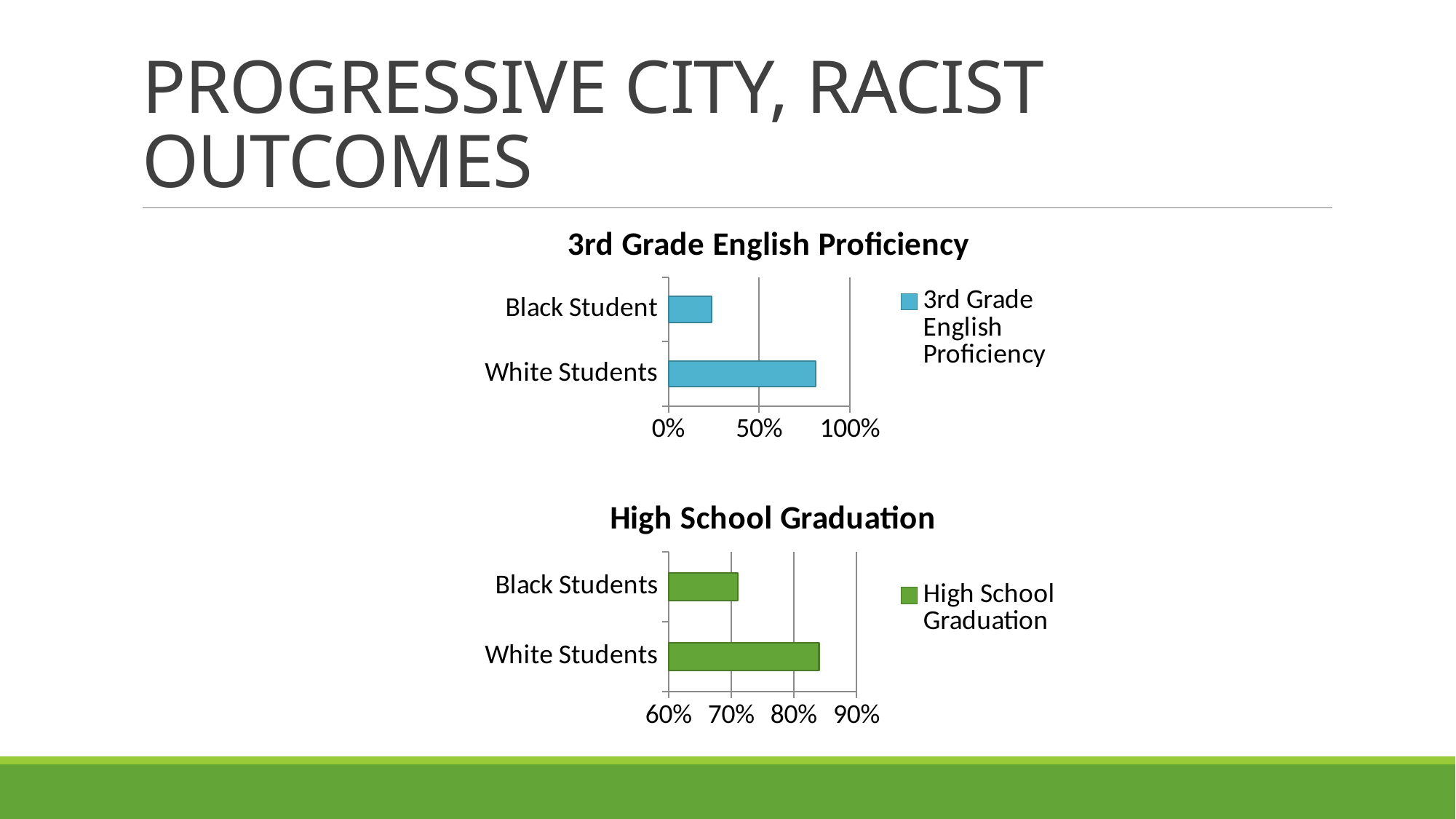
In the 3rd Grade English Proficiency chart, which category has the highest value? White Students In the High School Graduation chart, is the value for Black Students greater or less than 80%? less What kind of chart is the High School Graduation chart? bar chart In the 3rd Grade English Proficiency chart, is the value for Black Student greater or less than 50%? less In the High School Graduation chart, which category has the higher value, Black Students or White Students? White Students In the High School Graduation chart, is the value for White Students greater or less than 80%? greater What colour are the bars in the High School Graduation chart? green In the 3rd Grade English Proficiency chart, which category has the lowest value? Black Student What is the title of the top chart on the slide? 3rd Grade English Proficiency How many series does the legend of the 3rd Grade English Proficiency chart list? 1 How many categories are shown in the High School Graduation chart? 2